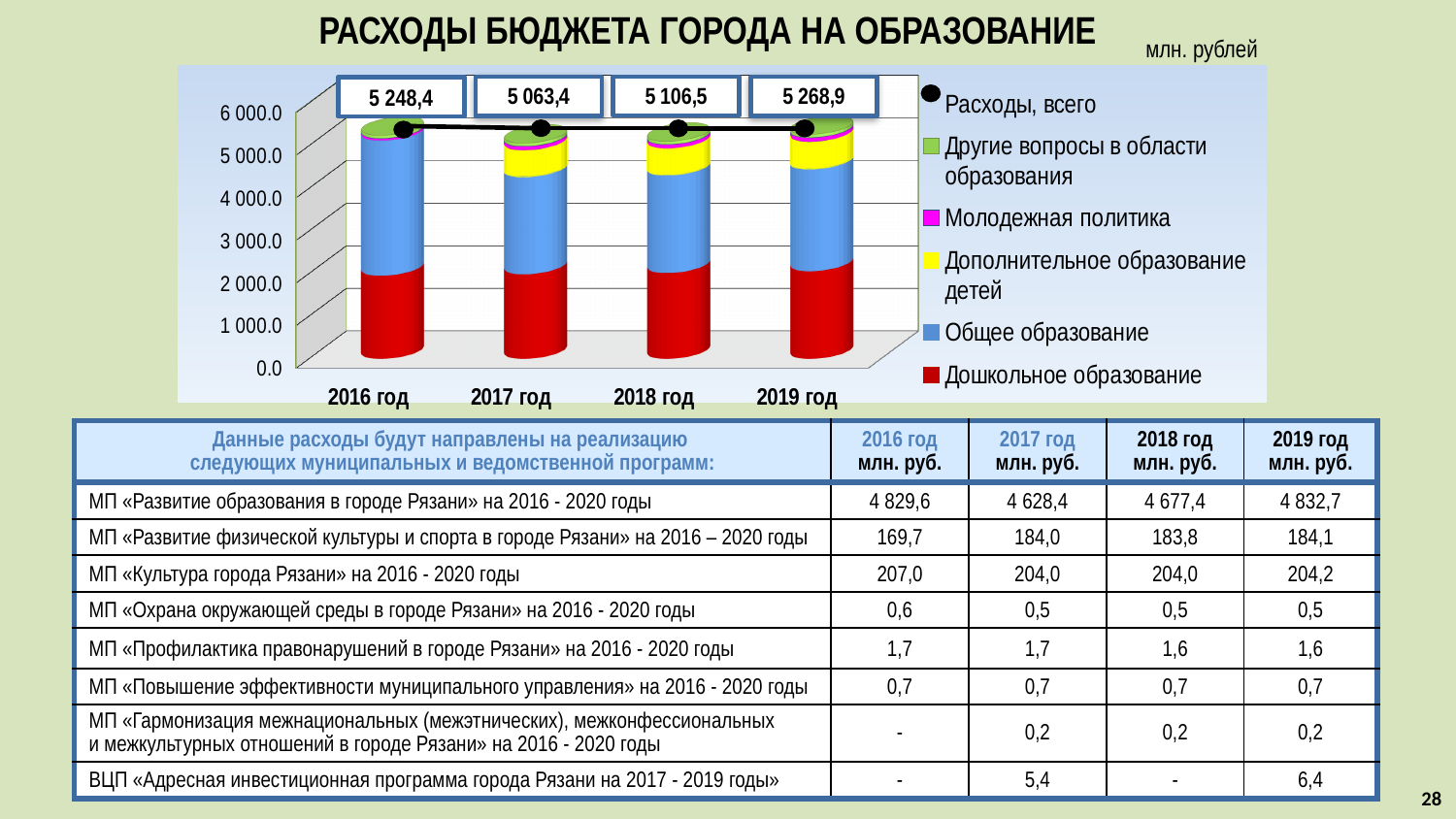
What type of chart is shown on the slide? Stacked bar chart with a line In which year is «Расходы, всего» the lowest? 2017 год What is the difference between «Расходы, всего» in 2019 год and 2016 год? 20,5 What is the difference between «Расходы, всего» in 2018 год and 2017 год? 43,1 In which year is «Расходы, всего» the highest? 2019 год What is the value of «Расходы, всего» for 2017 год? 5 063,4 How many series does the chart legend list? 6 What is the value of «Расходы, всего» for 2016 год? 5 248,4 Which is larger: «Расходы, всего» in 2018 год or in 2017 год? 2018 год How many years are shown on the x axis of the chart? 4 What is the value of «Расходы, всего» for 2019 год? 5 268,9 Is the value for «Дошкольное образование» in 2016 год greater or less than 3 000.0? less